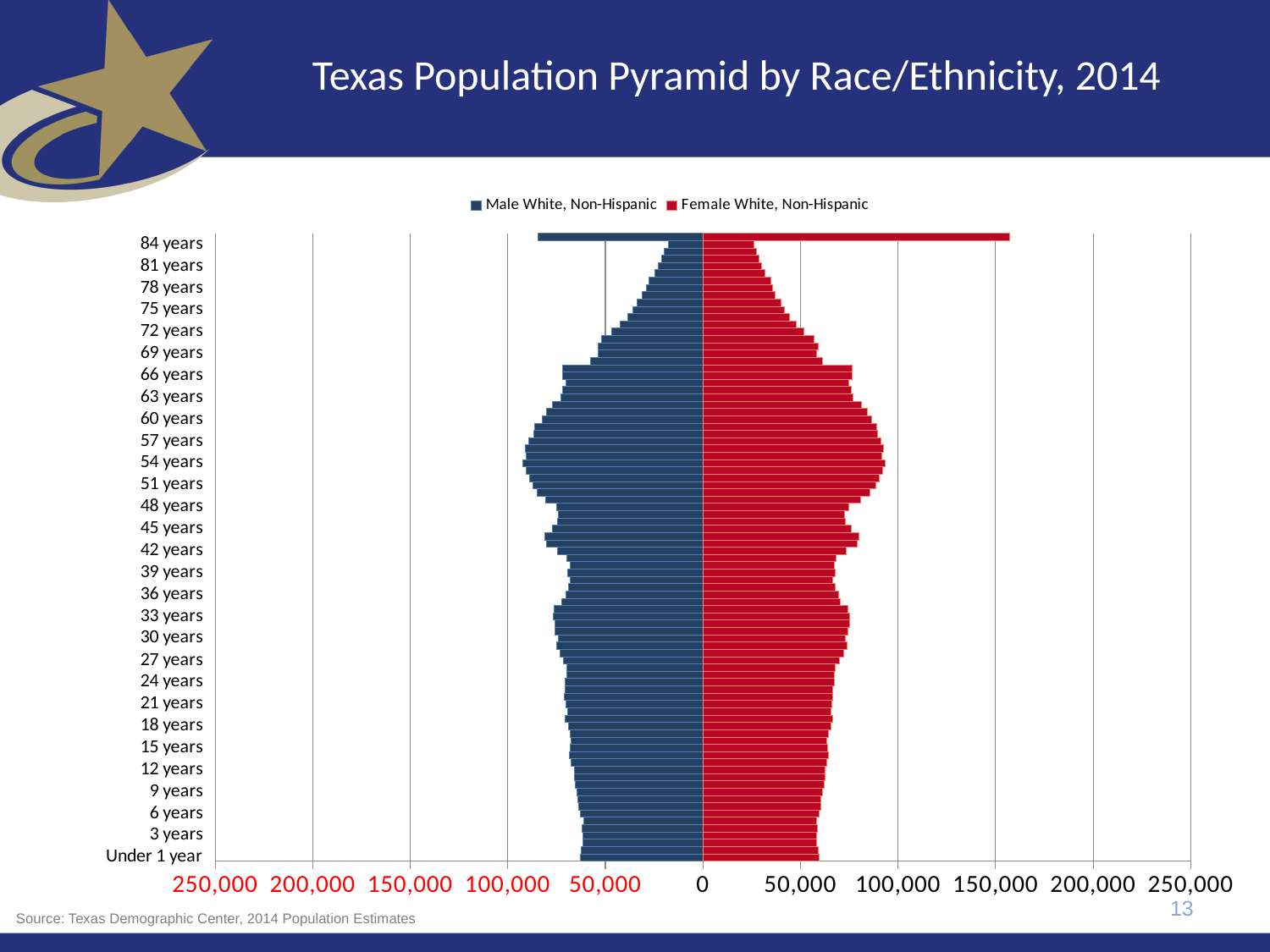
How many series does the legend list? 2 Is the Female White, Non-Hispanic value for Under 1 year greater or less than 50,000? greater What is the title of the chart? Texas Population Pyramid by Race/Ethnicity, 2014 Is the Male White, Non-Hispanic value for 75 years greater or less than 50,000? less Is the Female White, Non-Hispanic value for 84 years greater or less than 100,000? less For 84 years, which is larger: the Male White, Non-Hispanic value or the Female White, Non-Hispanic value? Female White, Non-Hispanic How many age labels are shown on the vertical axis? 29 For Female White, Non-Hispanic, which is larger: the value for 54 years or the value for 36 years? 54 years What kind of chart is shown on the slide? Bar chart (population pyramid) Which series is shown in red? Female White, Non-Hispanic